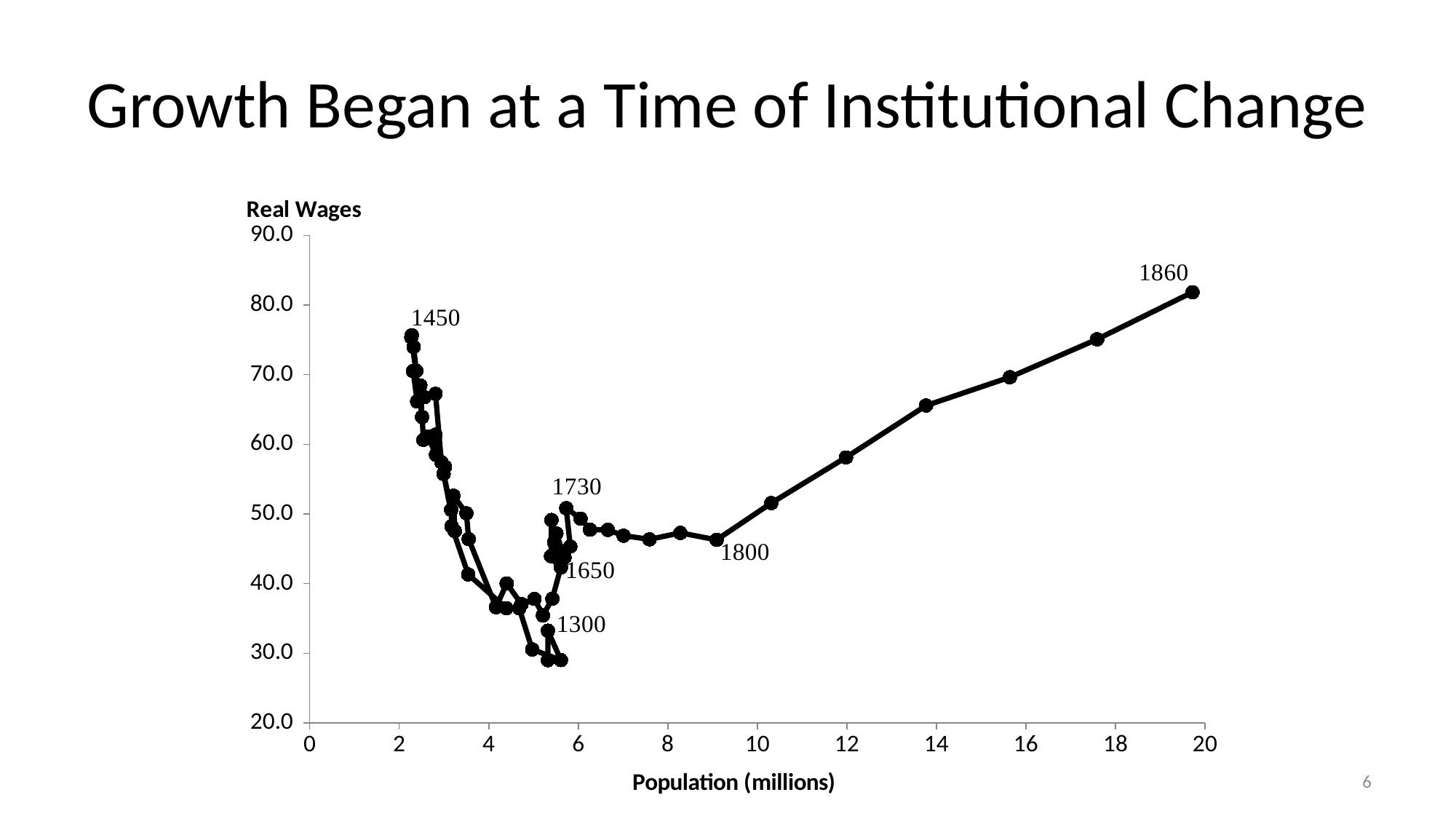
What is the title of the horizontal axis? Population (millions) Which point has higher real wages, the one labeled 1800 or the one labeled 1300? 1800 Is the real wage value for the point labeled 1800 greater or less than 50.0? less How many year labels are printed on the chart? 6 Is the real wage value for the point labeled 1860 greater or less than 80.0? greater Which point has higher real wages, the one labeled 1860 or the one labeled 1450? 1860 Is the population for the point labeled 1860 greater or less than 18 million? greater Of the years labeled on the chart, which has the highest real wages? 1860 What is the title of the vertical axis? Real Wages What kind of chart is shown on the slide? line chart